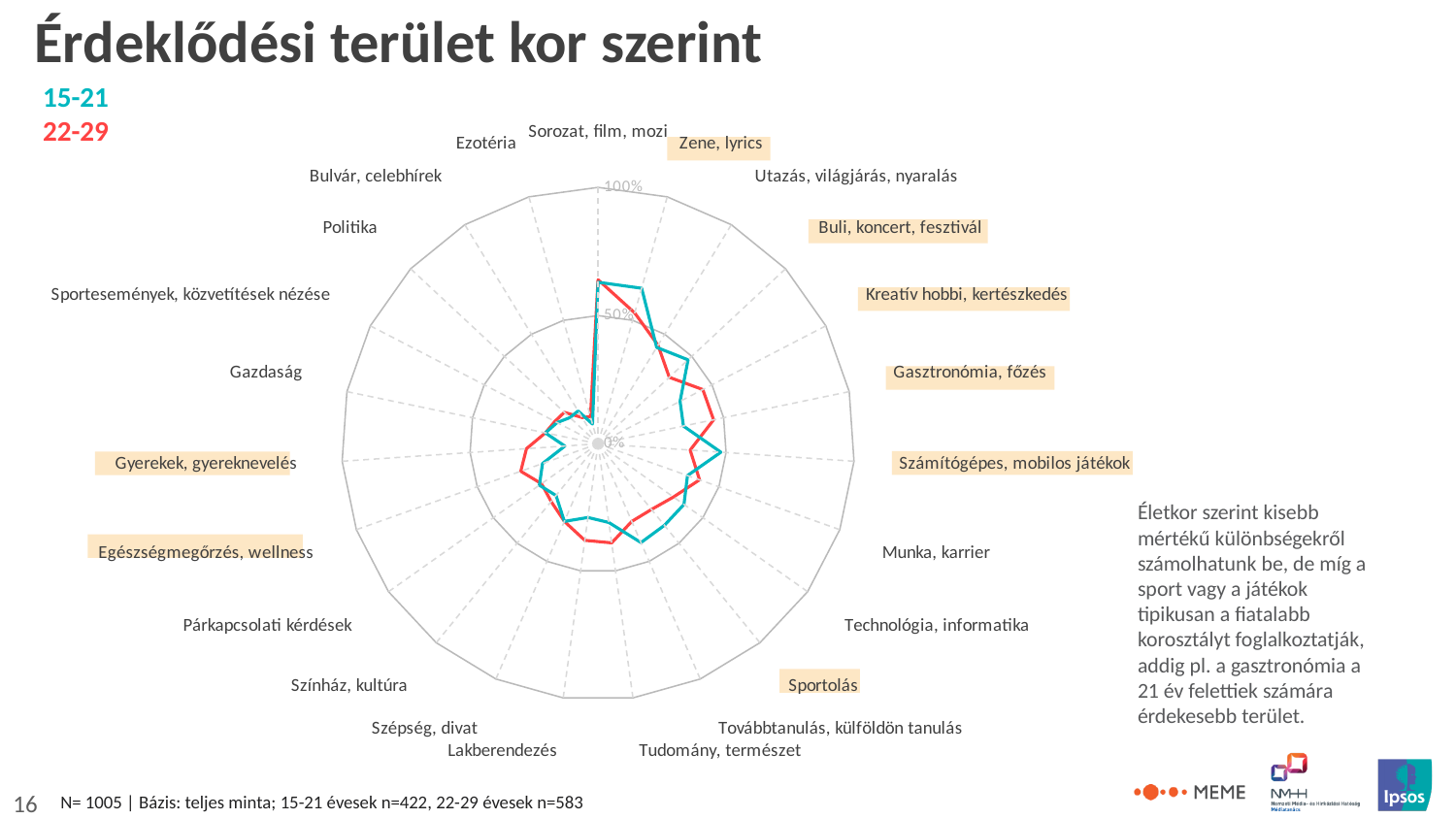
How many interest categories are plotted around the radar chart? 23 For 'Számítógépes, mobilos játékok', which age group has the larger value, 15-21 or 22-29? 15-21 Is the value for 'Ezotéria' for the 15-21 age group greater or less than 50%? less Is the value for 'Politika' for the 22-29 age group greater or less than 50%? less What is the title of the chart on the slide? Érdeklődési terület kor szerint For 'Gyerekek, gyereknevelés', which age group has the larger value, 15-21 or 22-29? 22-29 Is the value for 'Sorozat, film, mozi' for the 15-21 age group greater or less than 50%? greater Which colour represents the 22-29 age group in the chart? red What kind of chart is shown on the slide? radar chart For 'Gasztronómia, főzés', which age group has the larger value, 15-21 or 22-29? 22-29 How many series (age groups) does the chart's legend list? 2